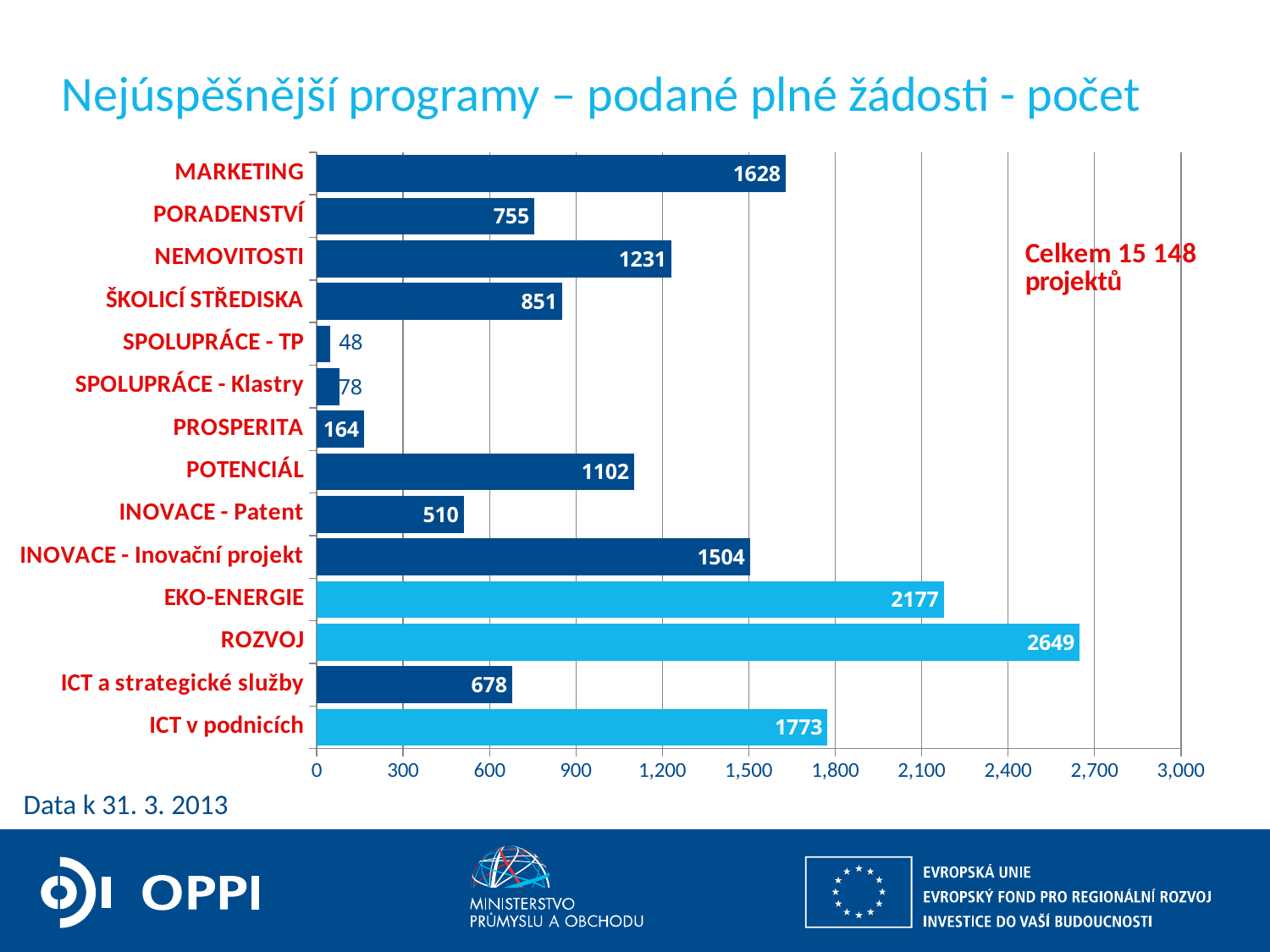
What is the difference between the values for MARKETING and PORADENSTVÍ? 873 Is the value for ICT v podnicích greater or less than 1,500? greater What is the value for EKO-ENERGIE? 2177 Which is larger, the value for NEMOVITOSTI or the value for POTENCIÁL? NEMOVITOSTI Which category has the highest value? ROZVOJ What total number of projects is stated in the text on the chart? 15 148 How many categories are shown in the chart? 14 Which category has the lowest value? SPOLUPRÁCE - TP What is the value for SPOLUPRÁCE - Klastry? 78 What is the value for MARKETING? 1628 What is the difference between the values for ROZVOJ and EKO-ENERGIE? 472 What kind of chart is shown on the slide? bar chart